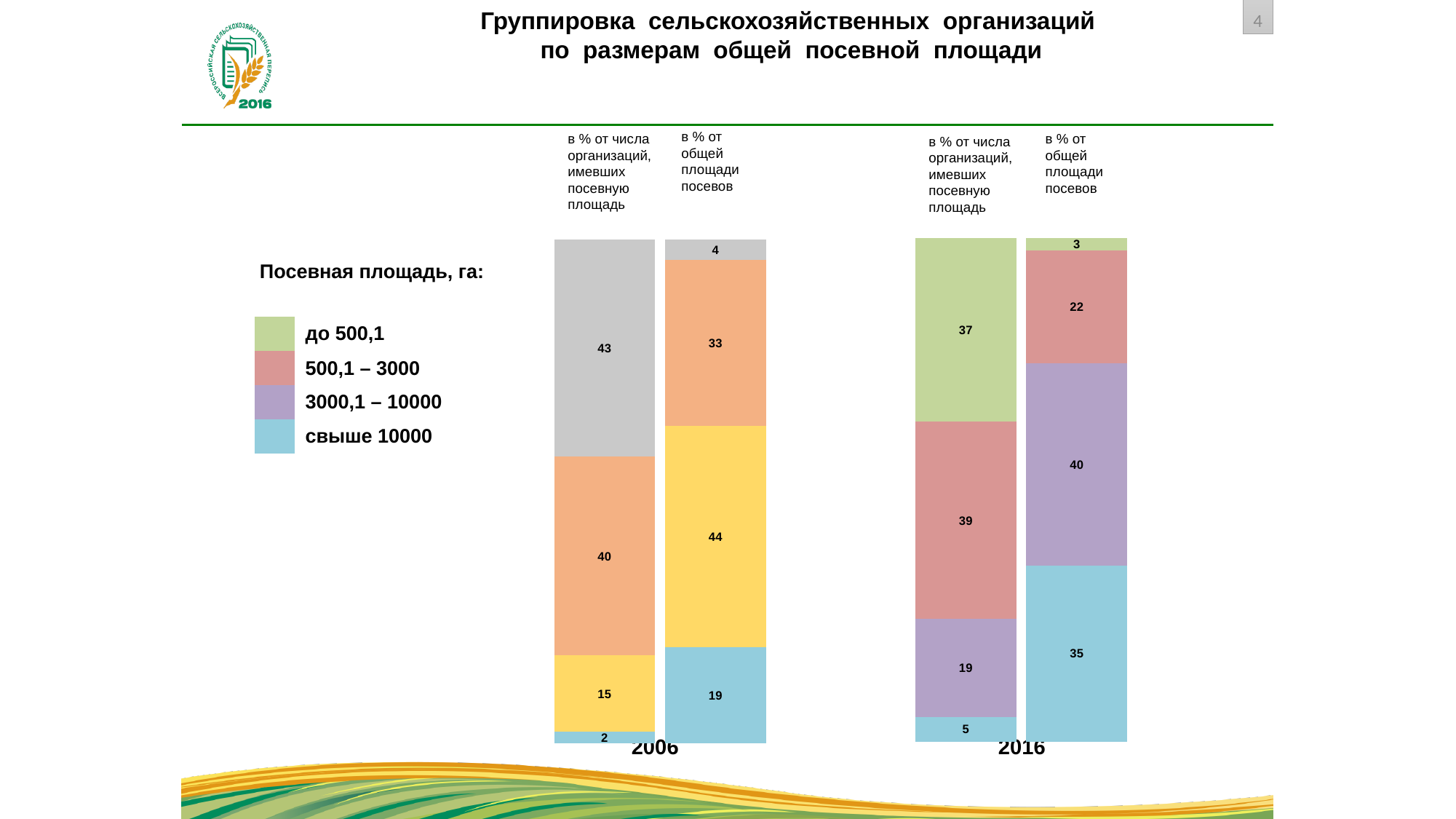
In the 2016 bar for '% от числа организаций, имевших посевную площадь', what is the value for the 'до 500,1' group? 37 In the 2016 bar for '% от общей площади посевов', which group has the largest segment? 3000,1 – 10000 In the 2016 bar for '% от числа организаций, имевших посевную площадь', what is the difference between the '500,1 – 3000' value and the 'до 500,1' value? 2 Comparing the bottom (blue) segments of the '% от числа организаций' bars, which year has the larger value: 2006 or 2016? 2016 How many stacked bars are shown on the slide in total? 4 How many groups does the legend list? 4 In the 2016 bar for '% от числа организаций, имевших посевную площадь', which group has the smallest segment? свыше 10000 What is the total of the 2016 bar for '% от общей площади посевов'? 100 In the 2006 bar for '% от общей площади посевов', what is the value of the bottom (blue) segment? 19 What kind of chart is shown on the slide? Stacked bar chart In the 2016 bar for '% от числа организаций, имевших посевную площадь', what is the value for the '3000,1 – 10000' group? 19 In the 2016 bar for '% от общей площади посевов', what is the value for the 'свыше 10000' group? 35